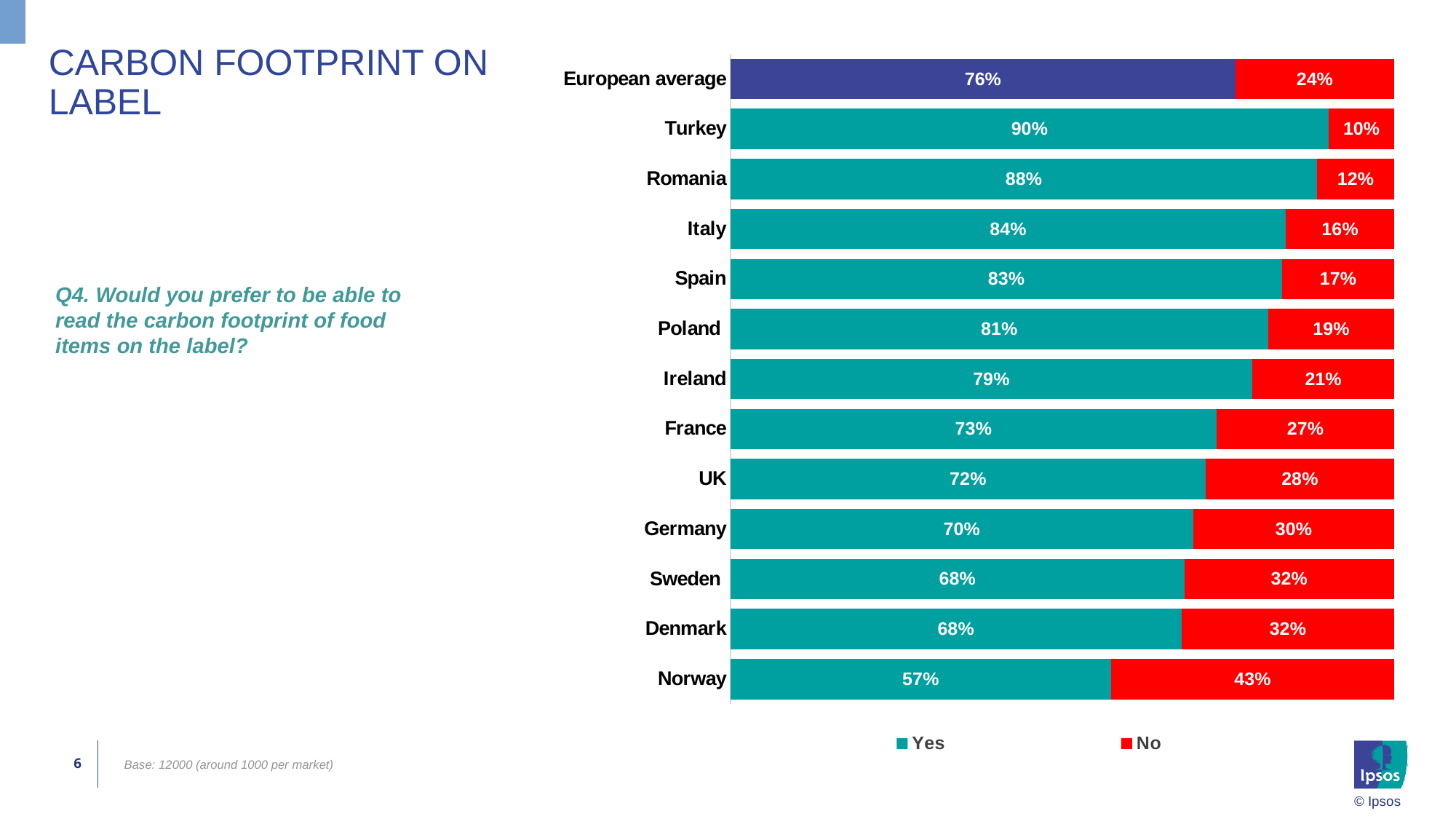
What is the difference between the Yes values for Italy and France? 11% What is the total of the Yes and No values for Sweden? 100% What colour represents the No series in the chart? Red What is the No value for Norway? 43% Which has a larger Yes value, Poland or Germany? Poland Which country has the lowest Yes percentage? Norway Which country has the highest Yes percentage? Turkey What percentage of respondents in Turkey answered Yes? 90% How many series does the legend list? 2 What is the Yes value for the European average? 76% How many countries (excluding the European average) are shown in the chart? 12 What kind of chart is shown on the slide? Stacked bar chart